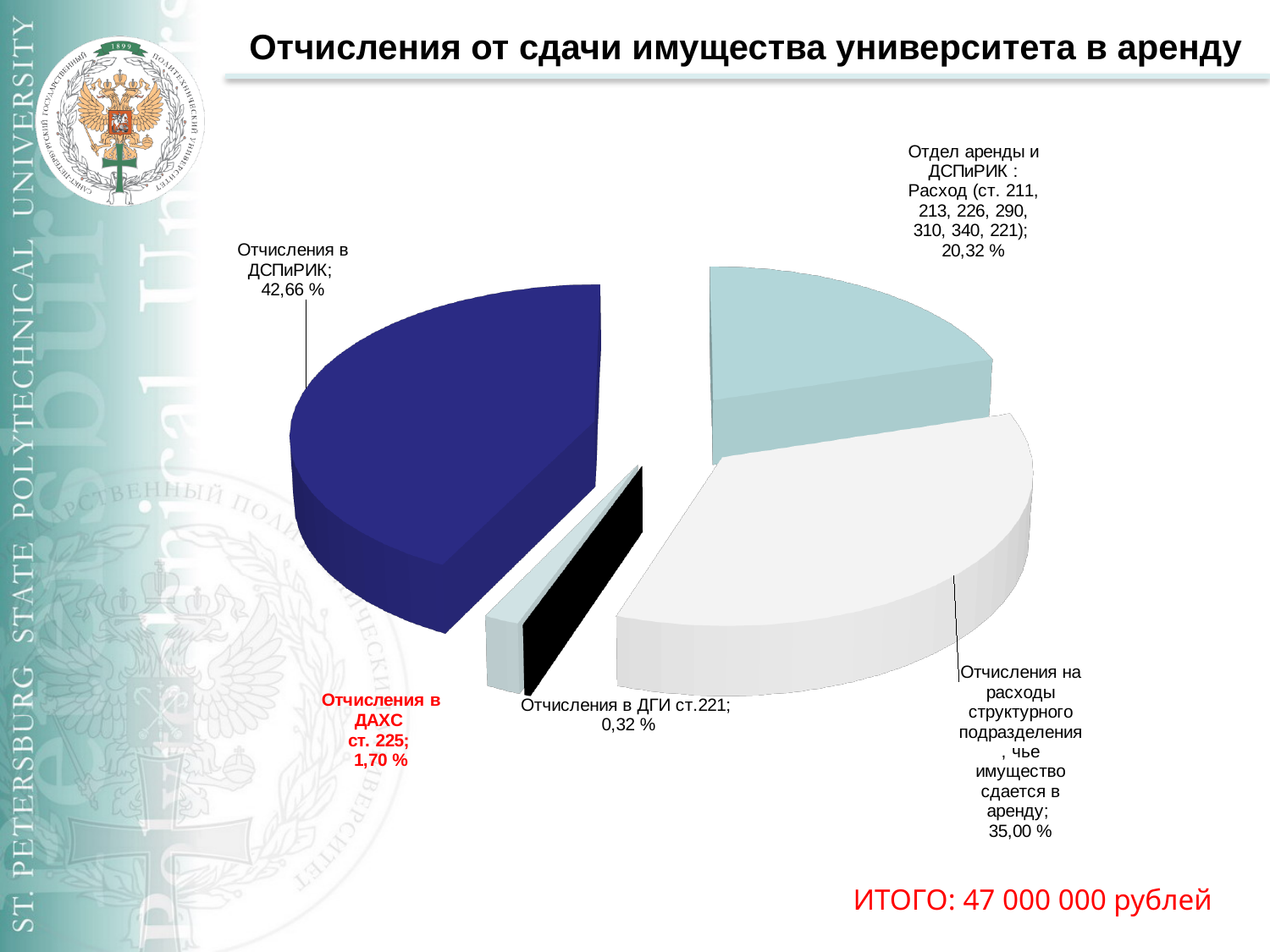
What share of the pie is labelled "Отчисления в ДАХС ст. 225"? 1,70 % What total amount (ИТОГО) is stated on the slide? 47 000 000 рублей What share of the pie is labelled "Отчисления в ДГИ ст.221"? 0,32 % Which is larger: the share for "Отчисления в ДСПиРИК" or the share for "Отчисления на расходы структурного подразделения, чье имущество сдается в аренду"? Отчисления в ДСПиРИК What is the title of the chart on the slide? Отчисления от сдачи имущества университета в аренду How many slices does the pie chart have? 5 What share of the pie is labelled "Отчисления в ДСПиРИК"? 42,66 % What kind of chart is shown on the slide? Pie chart What share of the pie is labelled "Отчисления на расходы структурного подразделения, чье имущество сдается в аренду"? 35,00 % What share of the pie is labelled "Отдел аренды и ДСПиРИК : Расход (ст. 211, 213, 226, 290, 310, 340, 221)"? 20,32 % Which slice of the pie chart is the largest? Отчисления в ДСПиРИК Which slice of the pie chart is the smallest? Отчисления в ДГИ ст.221